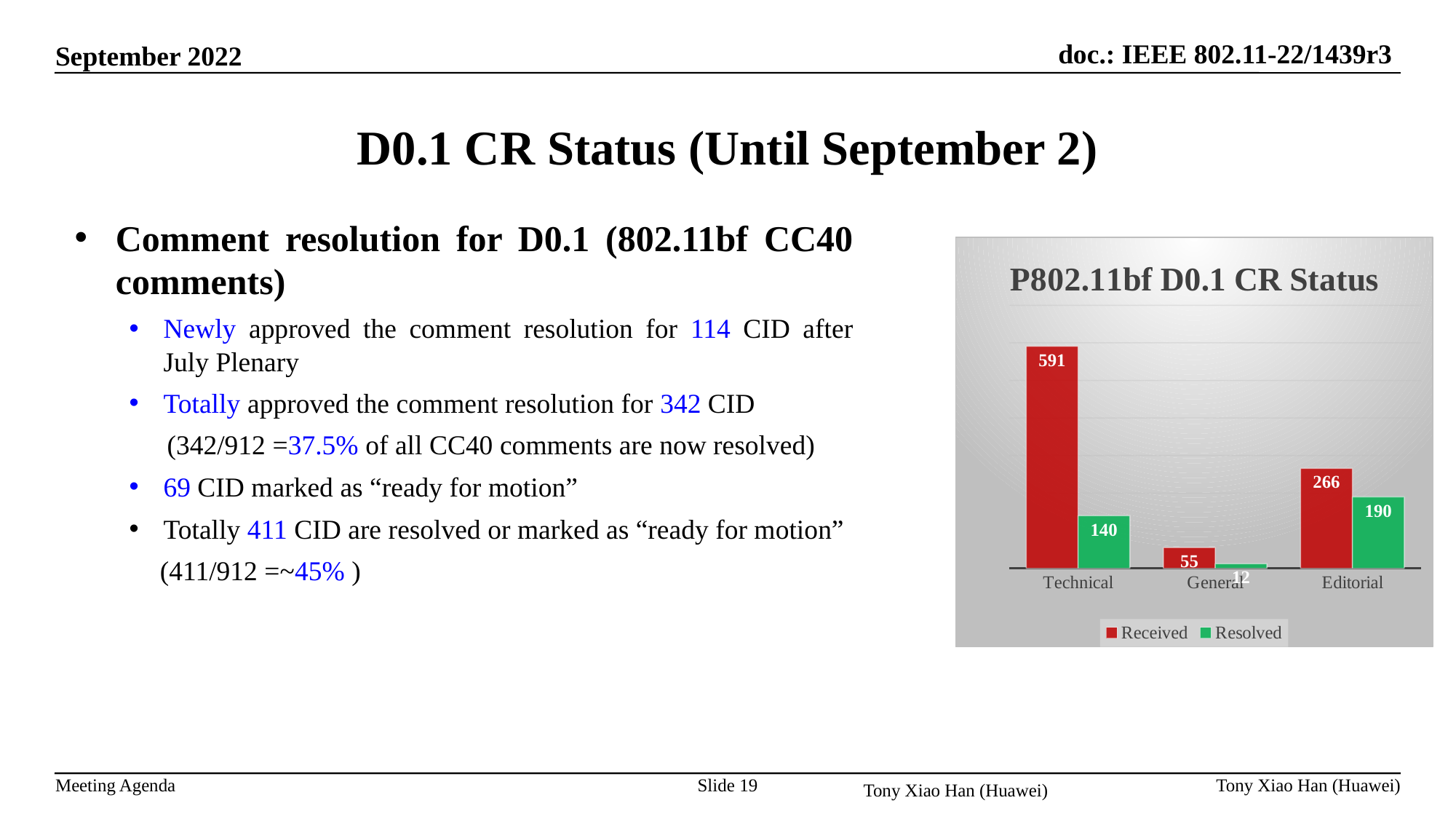
Which is larger, the Resolved value for Editorial or the Resolved value for Technical? Editorial What is the Received value for General? 55 What kind of chart is shown? Bar chart Which category has the highest Received value? Technical Which category has the lowest Resolved value? General How many series does the legend list? 2 What is the difference between Received and Resolved for Technical? 451 What is the Received value for Technical? 591 What is the difference between Received and Resolved for Editorial? 76 How many categories are shown on the x axis? 3 What is the Resolved value for Editorial? 190 What is the Resolved value for Technical? 140